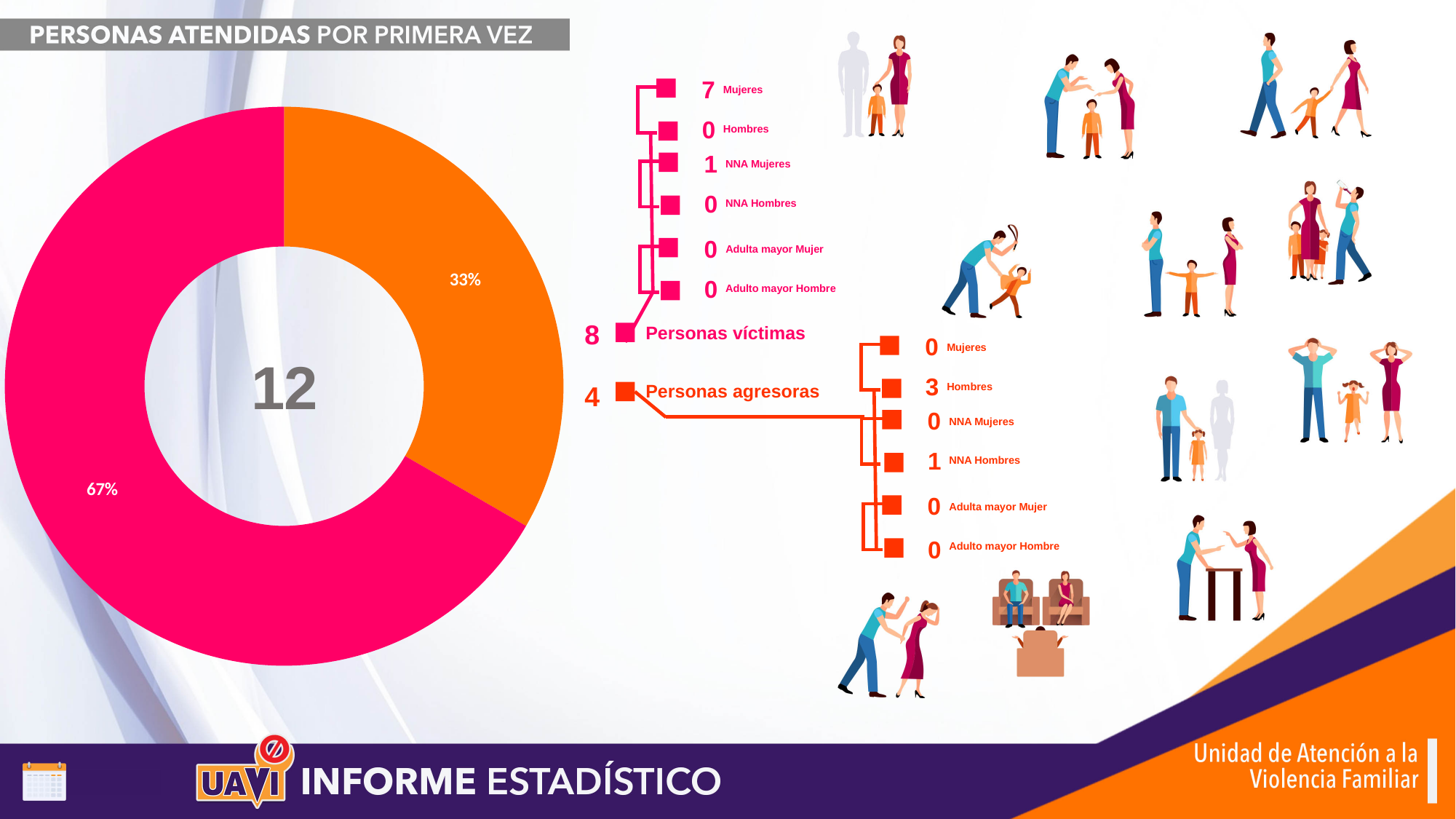
Among 'Personas agresoras', how many are 'Hombres'? 3 What is the total number shown in the centre of the donut chart? 12 How many 'Personas víctimas' are reported on the slide? 8 How many 'Personas agresoras' are reported on the slide? 4 What percentage is shown on the pink slice of the donut chart? 67% What percentage is shown on the orange slice of the donut chart? 33% Among 'Personas víctimas', how many are 'Mujeres'? 7 Which slice of the donut chart is larger, the pink one or the orange one? The pink one How many slices does the donut chart have? 2 What kind of chart is shown on the slide? Donut (pie) chart What is the title of the slide containing the donut chart? PERSONAS ATENDIDAS POR PRIMERA VEZ What is the difference in percentage points between the pink slice and the orange slice of the donut chart? 34 percentage points